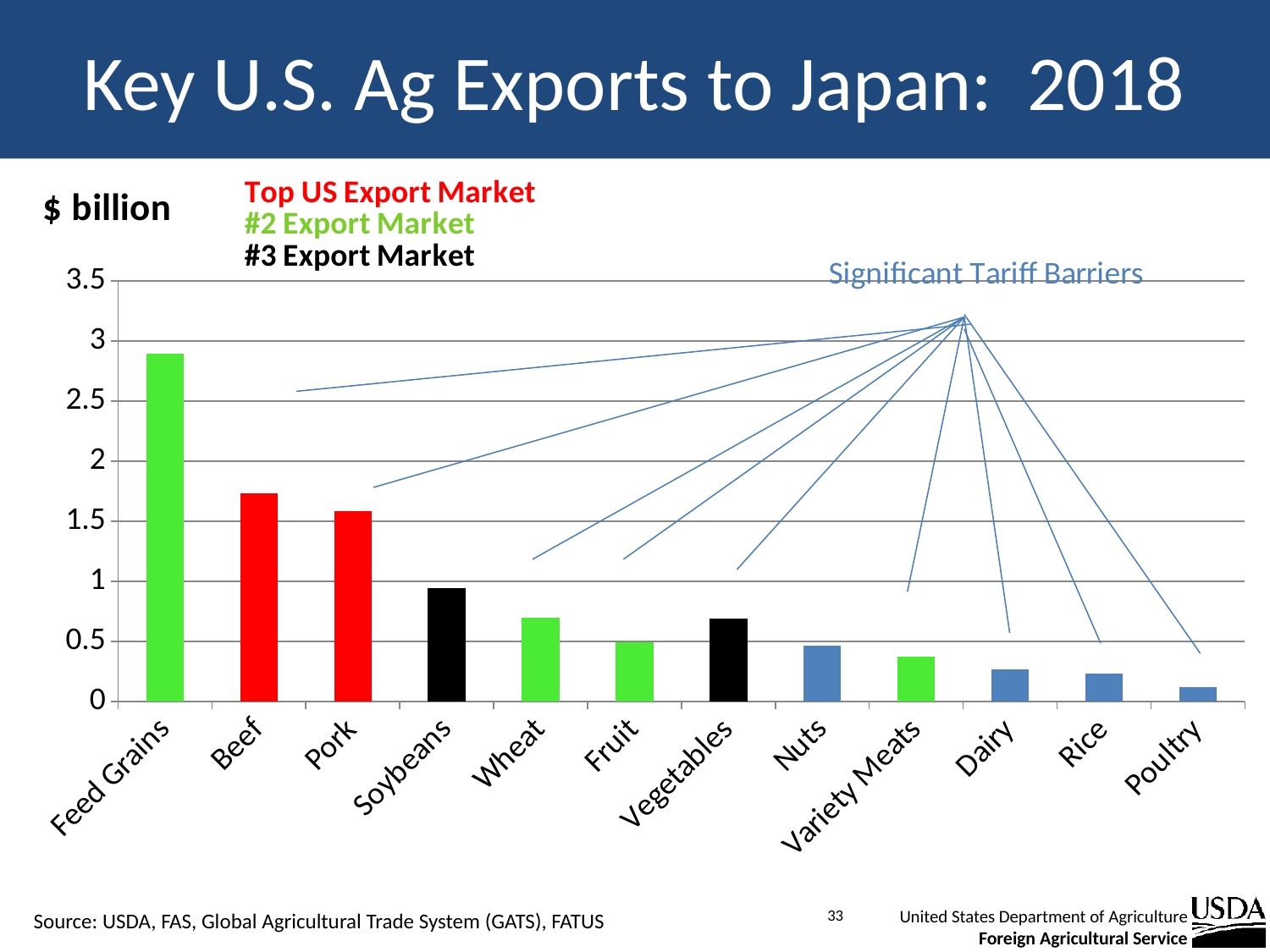
Is the value for Dairy greater or less than 0.5? less What kind of chart is shown on the slide? Bar chart Which category has the highest export value? Feed Grains Is the value for Feed Grains greater or less than 2.5? greater How many export categories are shown on the x axis? 12 Is the value for Beef greater or less than 1.5? greater What unit is shown for the y axis? $ billion What is the title of the slide? Key U.S. Ag Exports to Japan: 2018 Which is larger, the value for Beef or the value for Soybeans? Beef Which category has the lowest export value? Poultry Do the bar values generally rise or fall moving from left to right along the x axis? Fall